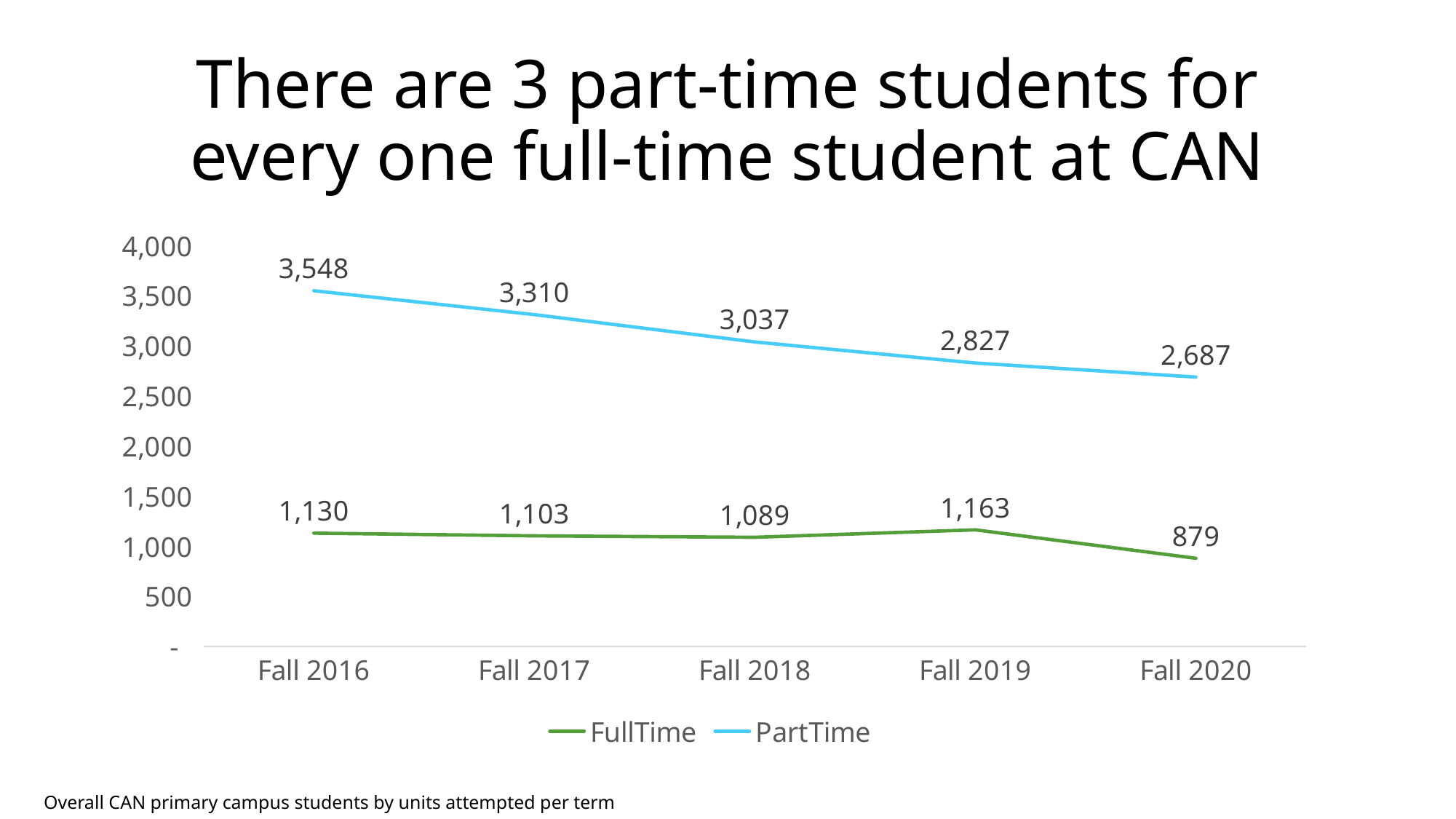
In which term is the PartTime value lowest? Fall 2020 Which is larger in Fall 2017, the FullTime value or the PartTime value? PartTime In which term is the FullTime value highest? Fall 2019 What is the PartTime value for Fall 2016? 3,548 Is the PartTime value for Fall 2019 greater or less than 3,000? less How many series does the legend list? 2 What is the FullTime value for Fall 2019? 1,163 How many terms are shown on the x axis? 5 By how much did the PartTime value fall from Fall 2016 to Fall 2020? 861 What kind of chart is shown on the slide? line chart What is the difference between the PartTime and FullTime values in Fall 2018? 1,948 What is the FullTime value for Fall 2020? 879